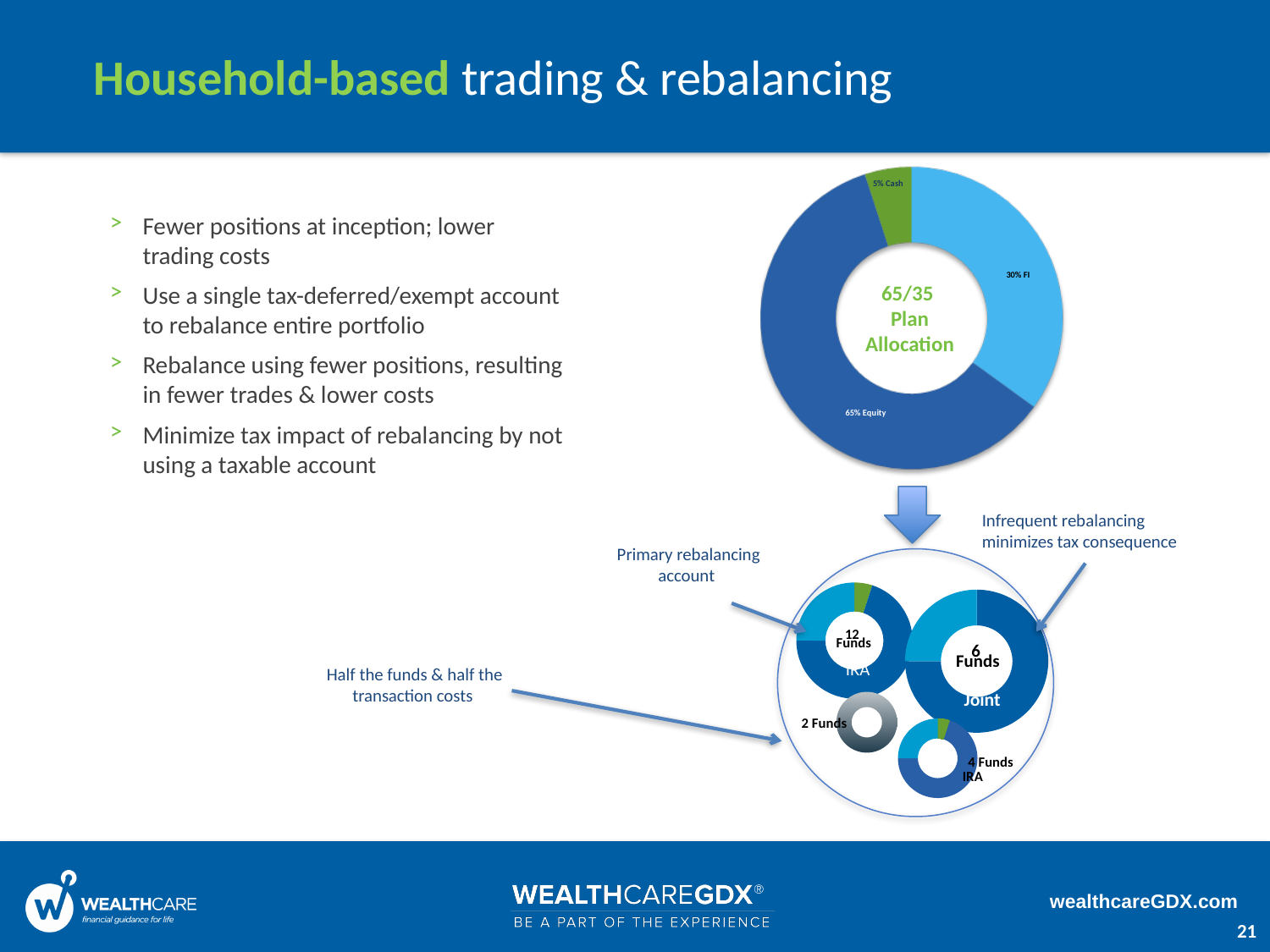
In the 65/35 Plan Allocation chart, which category has the largest share? Equity In the 65/35 Plan Allocation chart, what percentage is allocated to Cash? 5% In the 65/35 Plan Allocation chart, how many percentage points larger is the Equity share than the FI share? 35 percentage points In the 65/35 Plan Allocation chart, what percentage is allocated to Equity? 65% In the 65/35 Plan Allocation chart, how many percentage points larger is the FI share than the Cash share? 25 percentage points In the 65/35 Plan Allocation chart, what percentage is allocated to FI? 30% In the 65/35 Plan Allocation chart, which is larger, the FI share or the Cash share? FI In the 65/35 Plan Allocation chart, which category has the smallest share? Cash How many categories are shown in the 65/35 Plan Allocation chart? 3 What text appears in the centre of the large doughnut chart at the top right of the slide? 65/35 Plan Allocation What kind of chart is the 65/35 Plan Allocation chart? Doughnut (pie) chart How many small doughnut charts are shown inside the circle at the bottom right of the slide? 4